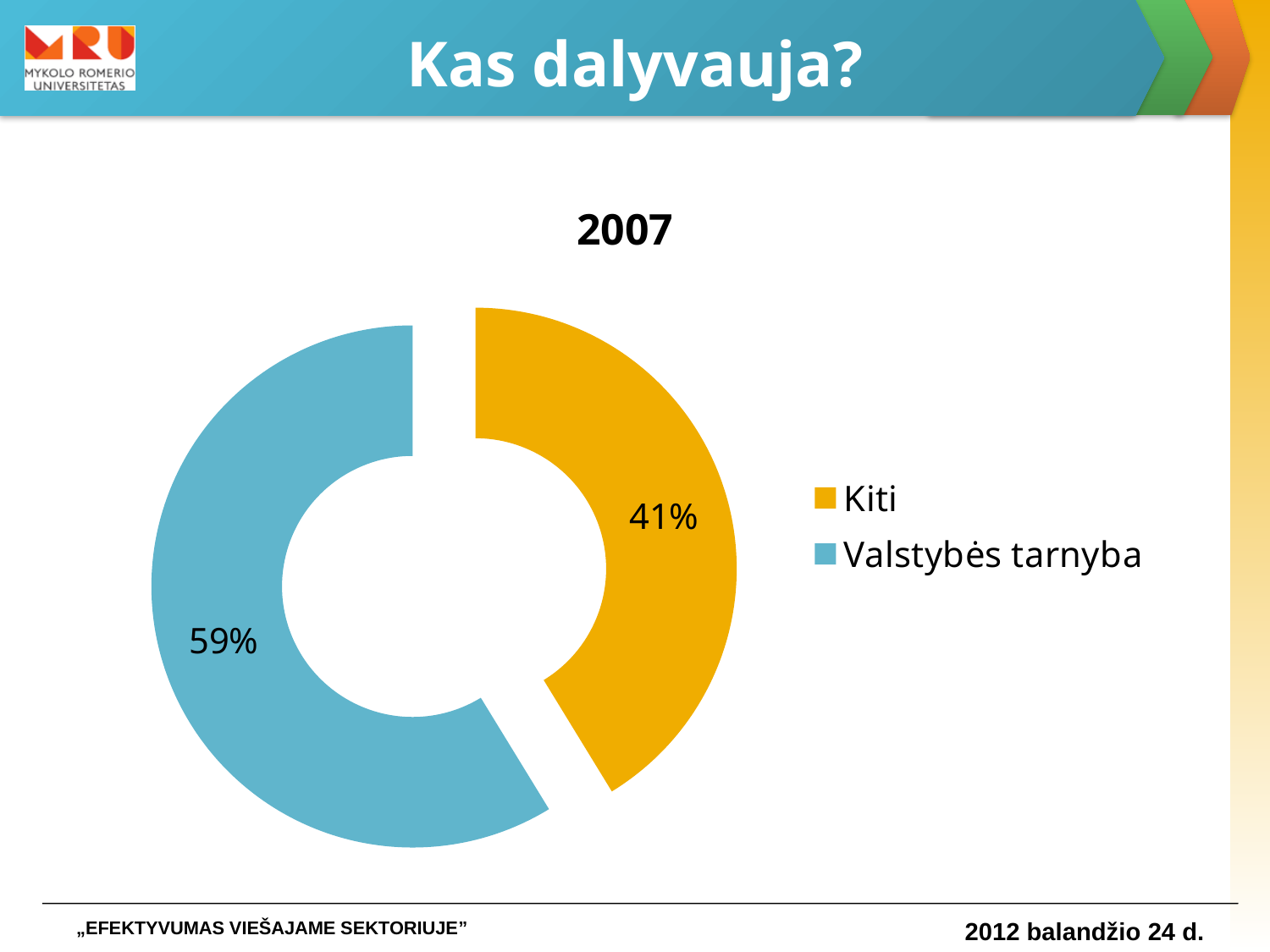
What colour represents Kiti in the chart? Orange Which category has the smallest share? Kiti What share of the chart does Valstybės tarnyba hold? 59% What is the difference in percentage points between Valstybės tarnyba and Kiti? 18 What kind of chart is shown on the slide? Pie chart (doughnut) How many categories does the chart show? 2 What is the title of the chart? 2007 Which is larger, the share for Kiti or the share for Valstybės tarnyba? Valstybės tarnyba What share of the chart does Kiti hold? 41% How many entries does the legend list? 2 Which category has the largest share? Valstybės tarnyba